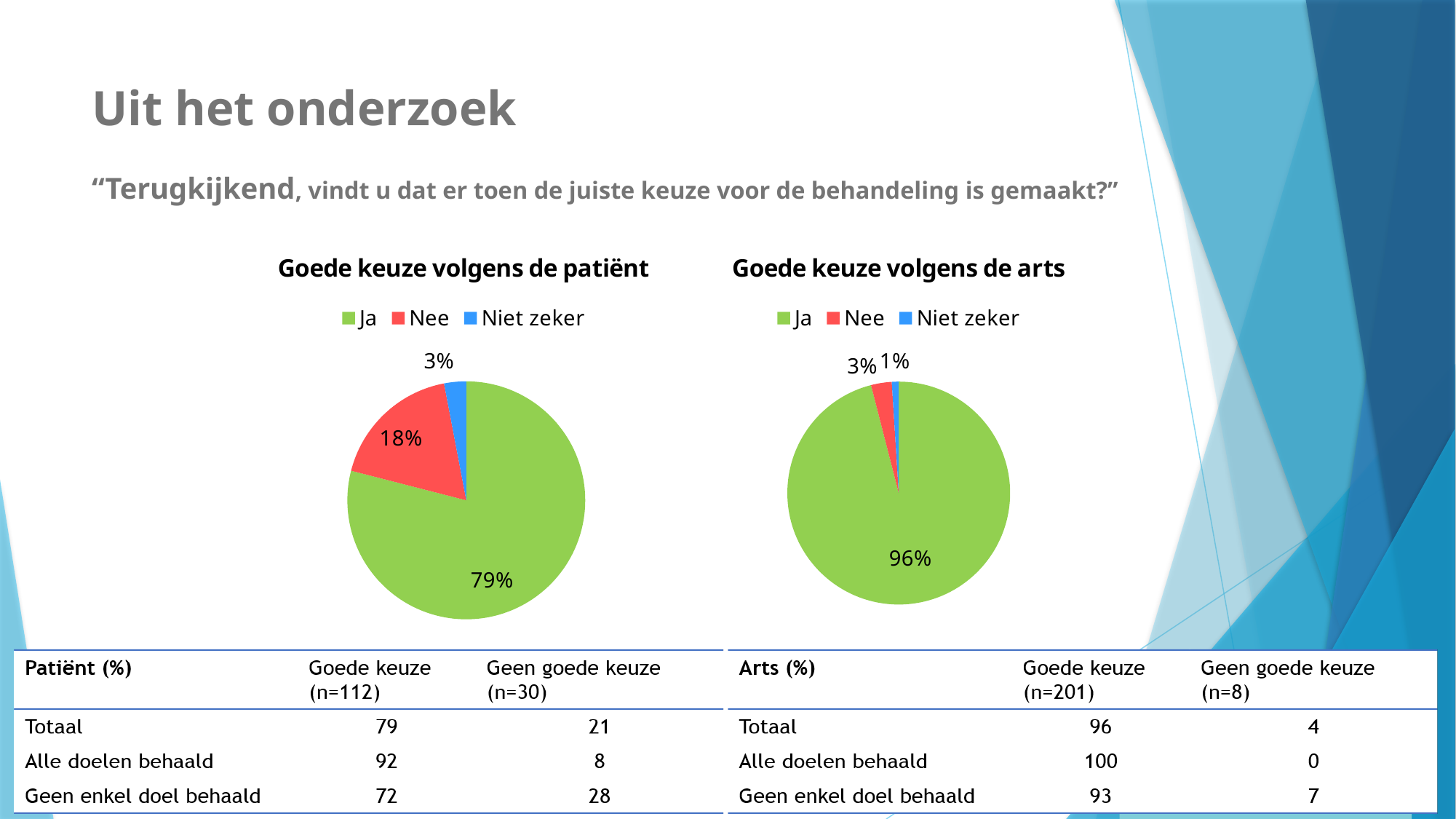
Which is larger: 'Nee' in 'Goede keuze volgens de patiënt' or 'Nee' in 'Goede keuze volgens de arts'? Nee in Goede keuze volgens de patiënt In the chart 'Goede keuze volgens de arts', which category has the largest slice? Ja In the chart 'Goede keuze volgens de arts', what share of the pie is 'Ja'? 96% What is the difference between the 'Ja' share in 'Goede keuze volgens de arts' and the 'Ja' share in 'Goede keuze volgens de patiënt'? 17% How many categories does the legend of 'Goede keuze volgens de arts' list? 3 In the chart 'Goede keuze volgens de patiënt', what is the value for 'Nee'? 18% What type of chart is 'Goede keuze volgens de patiënt'? Pie chart In the chart 'Goede keuze volgens de patiënt', which category has the smallest slice? Niet zeker In the chart 'Goede keuze volgens de arts', what is the value for 'Nee'? 3% In the chart 'Goede keuze volgens de patiënt', what share of the pie is 'Ja'? 79% In the chart 'Goede keuze volgens de patiënt', what is the value for 'Niet zeker'? 3% In the chart 'Goede keuze volgens de arts', what is the value for 'Niet zeker'? 1%